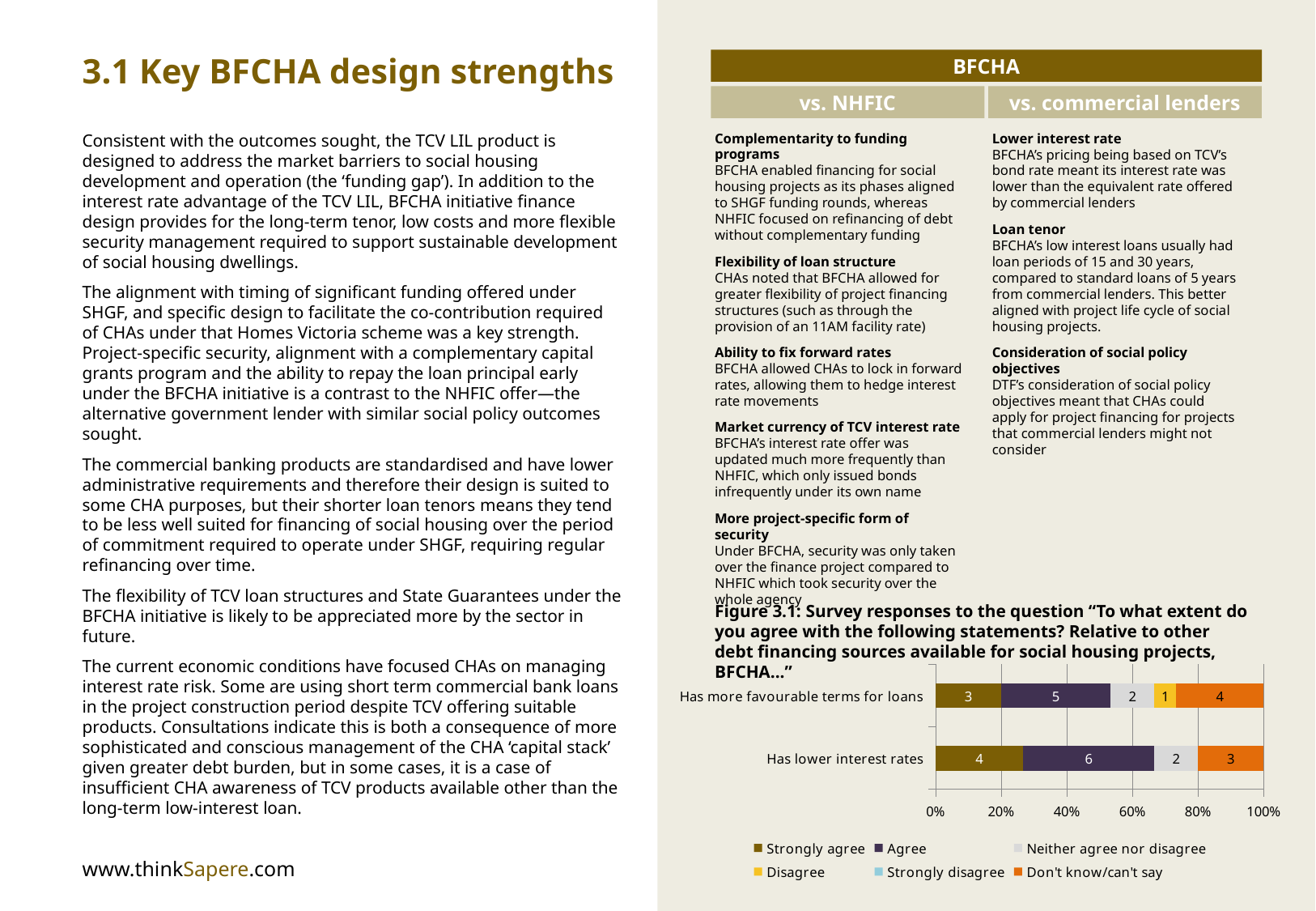
What is the highest value shown on the chart's horizontal axis? 100% How many respondents answered 'Don't know/can't say' for the statement 'Has more favourable terms for loans'? 4 How many response options does the chart legend list? 6 What is the difference in 'Don't know/can't say' responses between 'Has more favourable terms for loans' and 'Has lower interest rates'? 1 Which statement received more 'Agree' responses: 'Has lower interest rates' or 'Has more favourable terms for loans'? Has lower interest rates How many respondents answered 'Disagree' for the statement 'Has more favourable terms for loans'? 1 What is the total number of responses shown in the bar for 'Has more favourable terms for loans'? 15 How many respondents answered 'Agree' for the statement 'Has more favourable terms for loans'? 5 What kind of chart is Figure 3.1? Stacked bar chart What is the total number of responses shown in the bar for 'Has lower interest rates'? 15 How many respondents answered 'Strongly agree' for the statement 'Has lower interest rates'? 4 How many statements (categories) are plotted in the chart? 2